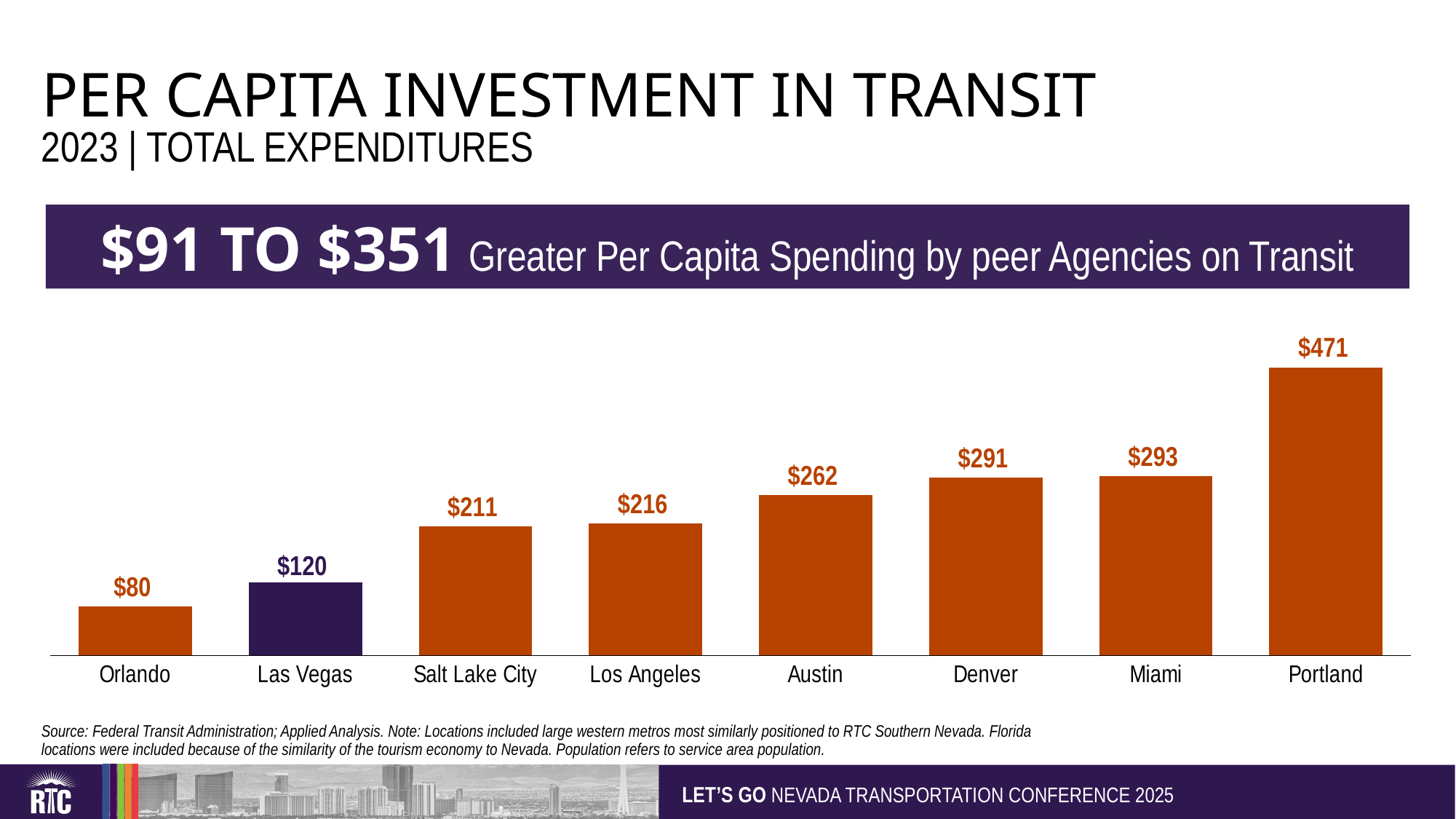
Do the values rise or fall from left to right across the cities? Rise What is the difference between Portland's and Las Vegas's per capita investment? $351 Which city has the highest per capita investment in transit? Portland What is the difference between Denver's and Austin's values? $29 What is the value shown for Salt Lake City? $211 Which has a higher per capita investment, Los Angeles or Miami? Miami Which city's bar is coloured purple instead of orange? Las Vegas What is the per capita investment in transit for Las Vegas? $120 Which city has the lowest per capita investment in transit? Orlando What is the per capita investment in transit for Portland? $471 What kind of chart is shown on the slide? Bar chart How many cities are shown in the chart? 8